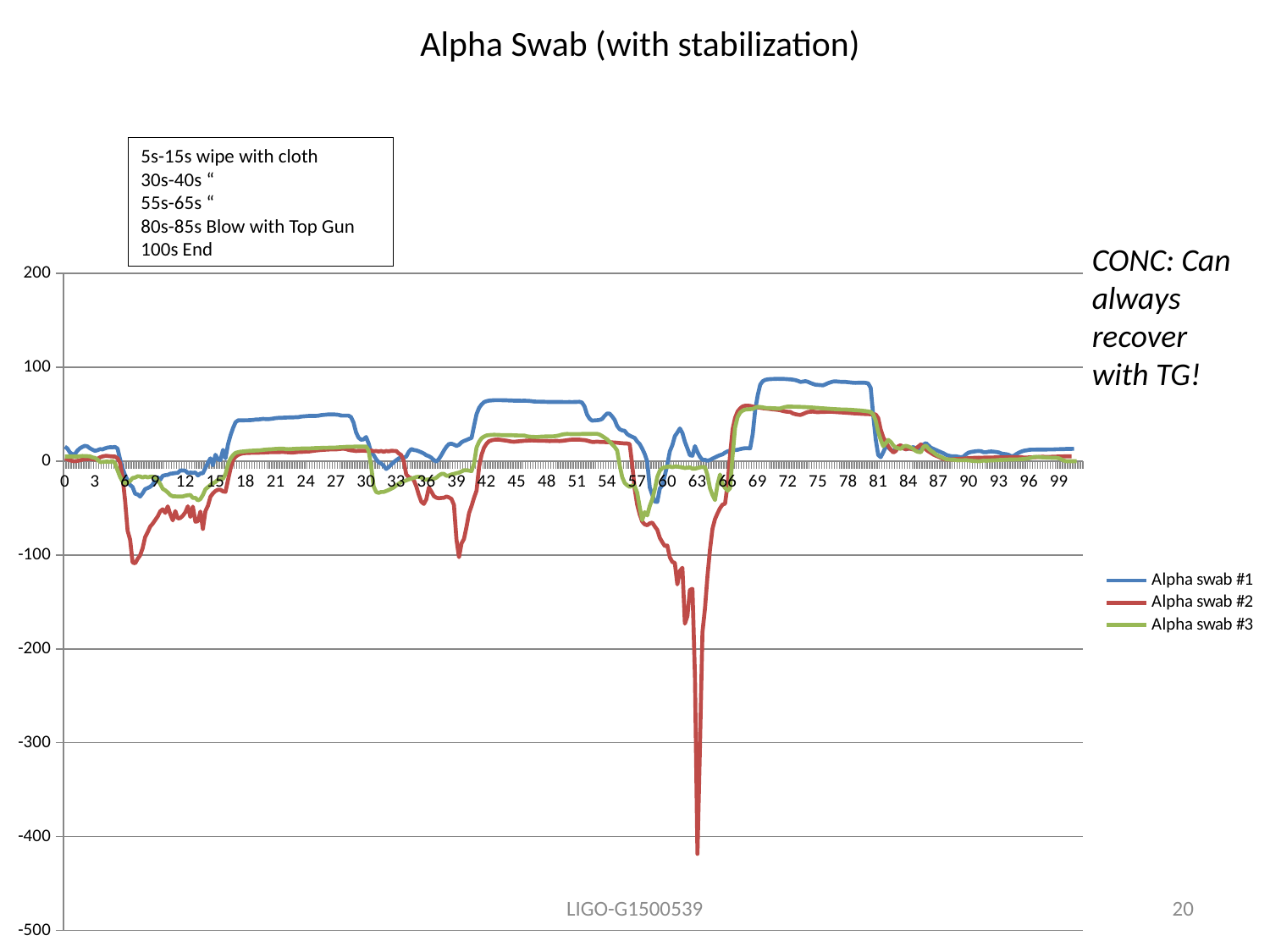
Which colour is used for the Alpha swab #2 line? red What kind of chart is shown on the slide? line chart Is the lowest value of Alpha swab #2 greater or less than -300? less Which series reaches the highest value anywhere on the chart? Alpha swab #1 What is the title of the chart? Alpha Swab (with stabilization) Is the value of Alpha swab #1 at x = 72 greater or less than 100? less How many series does the legend list? 3 Which series reaches the lowest value anywhere on the chart? Alpha swab #2 Is the value of Alpha swab #1 at x = 45 greater or less than 0? greater What is the lowest value labelled on the y axis? -500 At x = 63, which series has the lower value, Alpha swab #1 or Alpha swab #2? Alpha swab #2 At x = 72, which series has the higher value, Alpha swab #1 or Alpha swab #3? Alpha swab #1